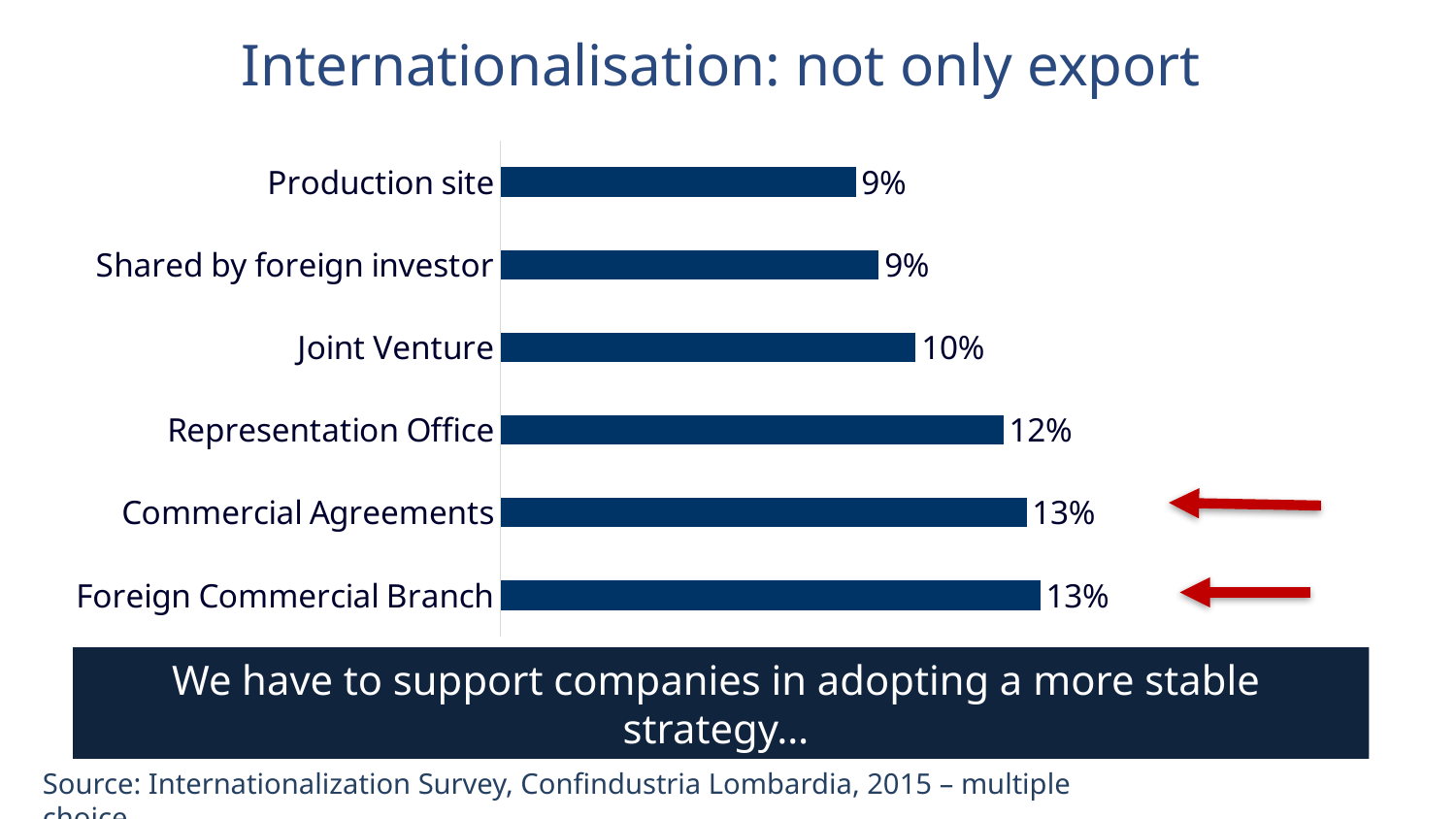
How many categories are shown in the chart? 6 What is the value for Production site? 9% What is the value for Shared by foreign investor? 9% Which is larger, the value for Representation Office or the value for Joint Venture? Representation Office What is the difference between the values for Commercial Agreements and Production site? 4% What is the value for Joint Venture? 10% What is the difference between the values for Representation Office and Joint Venture? 2% What kind of chart is shown on the slide? Bar chart What is the value for Representation Office? 12% What is the value for Foreign Commercial Branch? 13% What is the value for Commercial Agreements? 13% Which two categories are marked with red arrows? Commercial Agreements and Foreign Commercial Branch